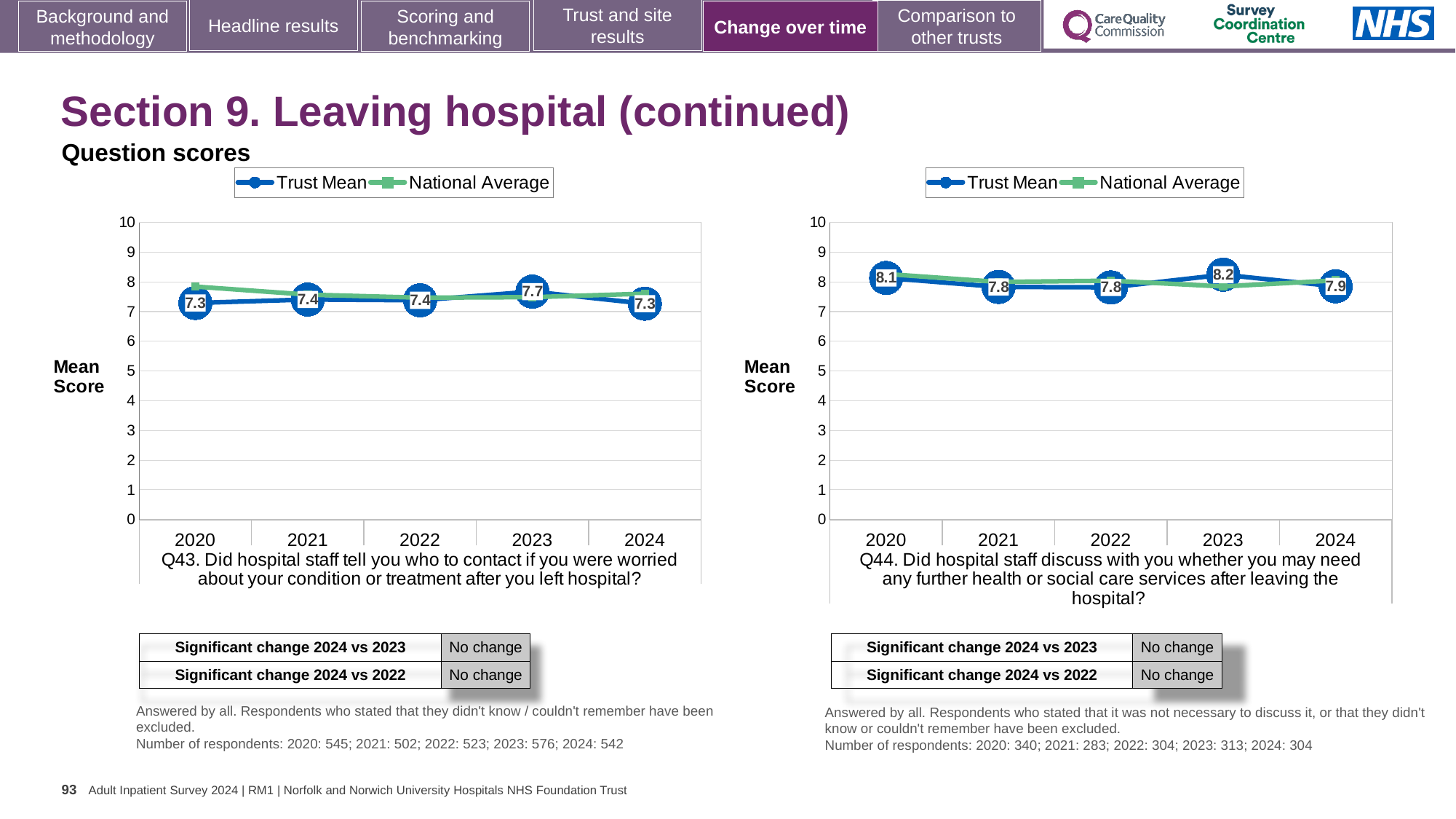
In the Q43 chart, what is the Trust Mean score for 2023? 7.7 What kind of chart is the Q43 chart? Line chart In the Q44 chart, which year has the highest Trust Mean score? 2023 How many series does the legend of the Q44 chart list? 2 In the Q43 chart, what is the difference between the Trust Mean scores for 2023 and 2024? 0.4 In the Q44 chart, what is the Trust Mean score for 2020? 8.1 In the Q43 chart, which year has the highest Trust Mean score? 2023 In the Q44 chart, which year has the larger Trust Mean score, 2020 or 2024? 2020 How many years are plotted on the x axis of the Q43 chart? 5 In the Q44 chart, what is the difference between the Trust Mean scores for 2020 and 2021? 0.3 In the Q43 chart, is the National Average value for 2020 greater or less than 7? greater In the Q44 chart, what is the Trust Mean score for 2024? 7.9